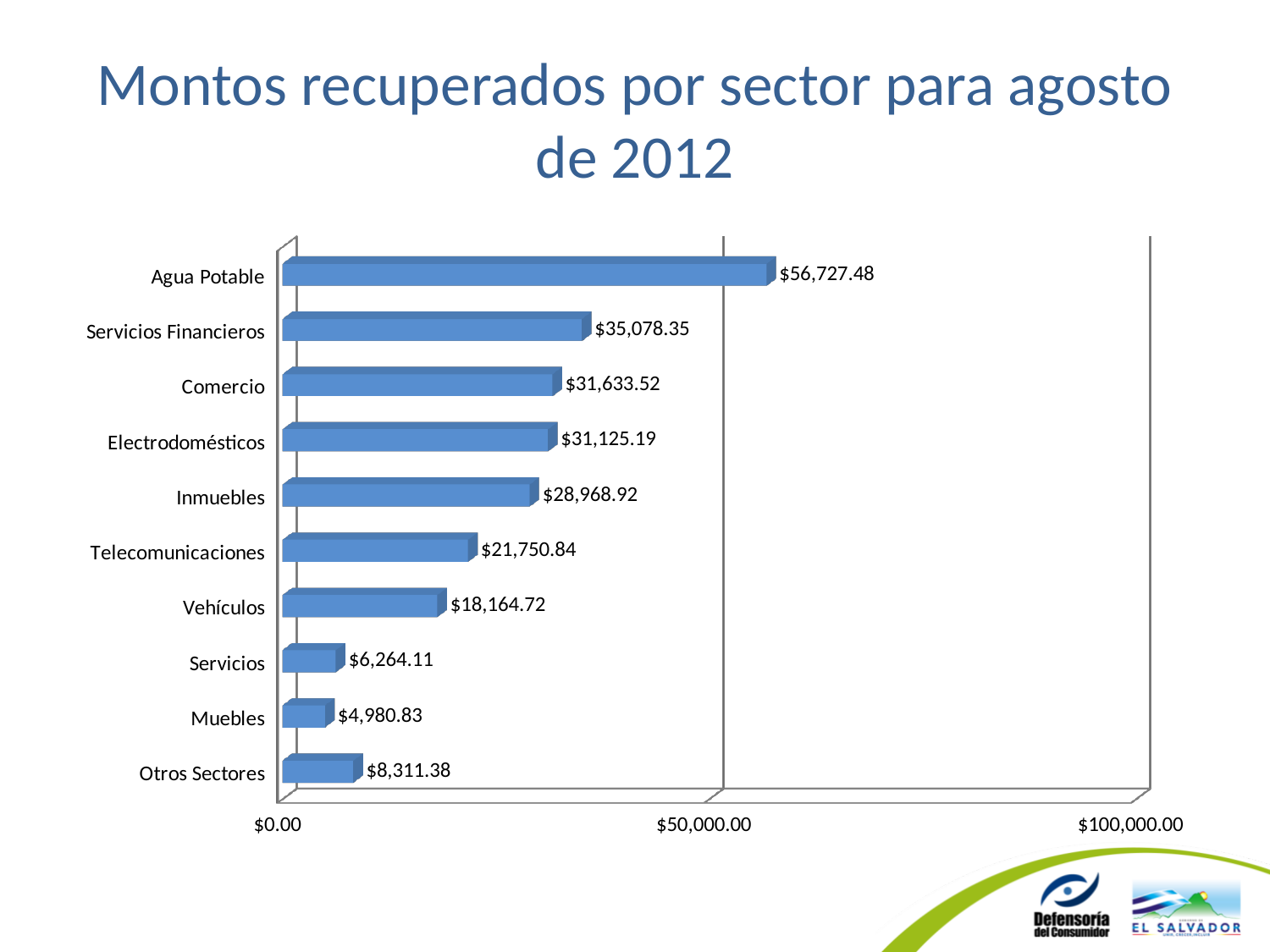
Is the value for Agua Potable greater or less than $50,000.00? greater What kind of chart is shown on the slide? Bar chart What is the value for Muebles? $4,980.83 What is the difference between the values for Agua Potable and Servicios Financieros? $21,649.13 What is the value for Agua Potable? $56,727.48 How many sectors are shown in the chart? 10 Which sector has the highest recovered amount? Agua Potable What is the title of the chart on the slide? Montos recuperados por sector para agosto de 2012 Which sector has the lowest recovered amount? Muebles What is the difference between the values for Otros Sectores and Muebles? $3,330.55 Which is larger, the value for Comercio or the value for Electrodomésticos? Comercio What is the value for Telecomunicaciones? $21,750.84